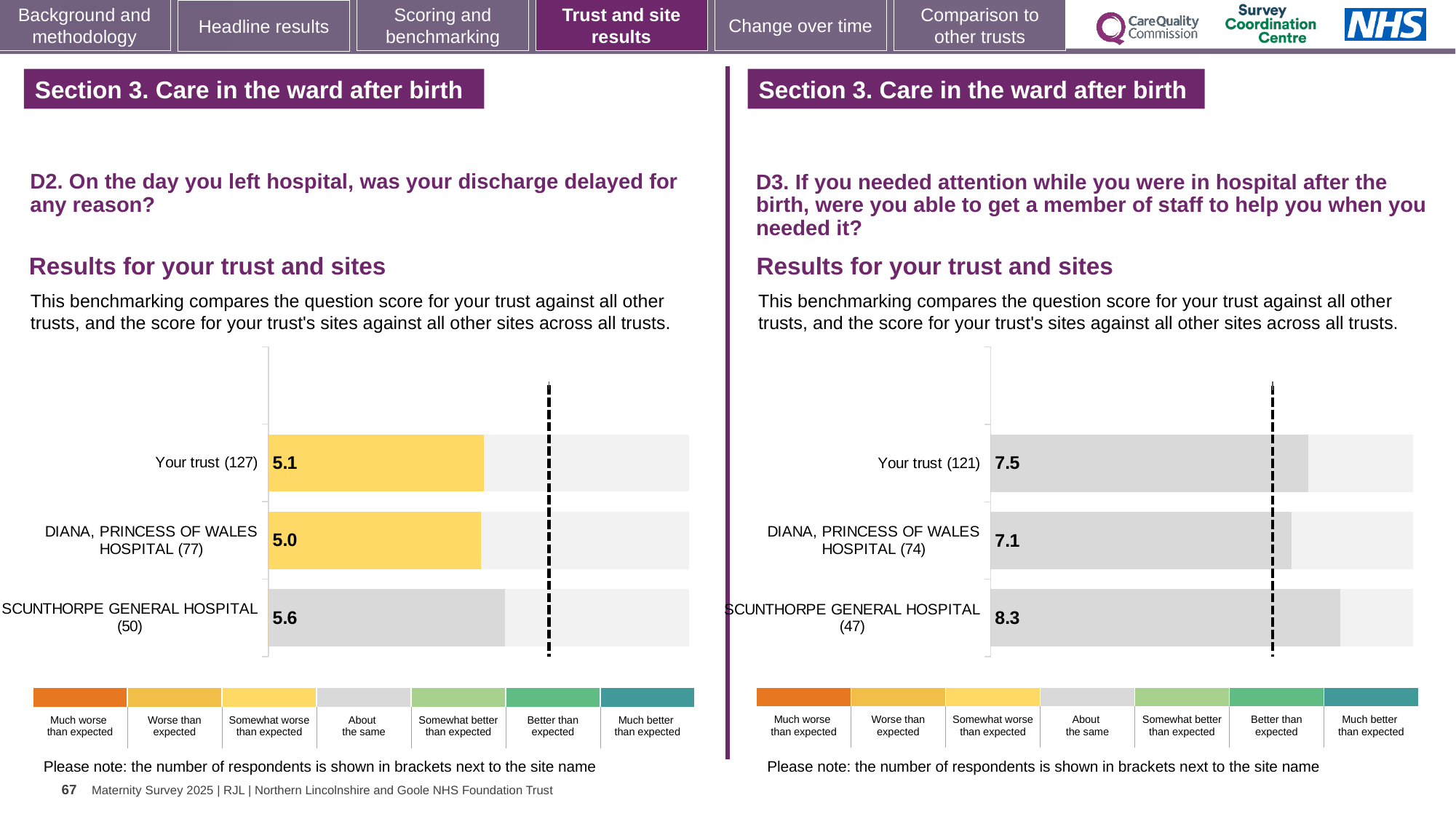
What kind of chart is used for the D3 results on the right? Bar chart In the D2 chart on the left, which benchmark category does the yellow colour of the Your trust bar represent according to the legend? Somewhat worse than expected In the D2 chart on the left, what is the difference between the scores for Scunthorpe General Hospital and Diana, Princess of Wales Hospital? 0.6 In the D3 chart on the right, what is the difference between the scores for Scunthorpe General Hospital and Your trust? 0.8 How many bars are plotted in the D2 chart on the left? 3 In the D3 chart on the right, which site or trust has the highest score? Scunthorpe General Hospital In the D2 chart on the left, what is the score for Scunthorpe General Hospital? 5.6 In the D2 chart on the left, how many respondents are shown in brackets for Your trust? 127 In the D3 chart on the right, which has the larger score: Your trust or Diana, Princess of Wales Hospital? Your trust In the D2 chart on the left, what is the score for Your trust? 5.1 In the D2 chart on the left, which site or trust has the lowest score? Diana, Princess of Wales Hospital In the D3 chart on the right, what is the score for Diana, Princess of Wales Hospital? 7.1